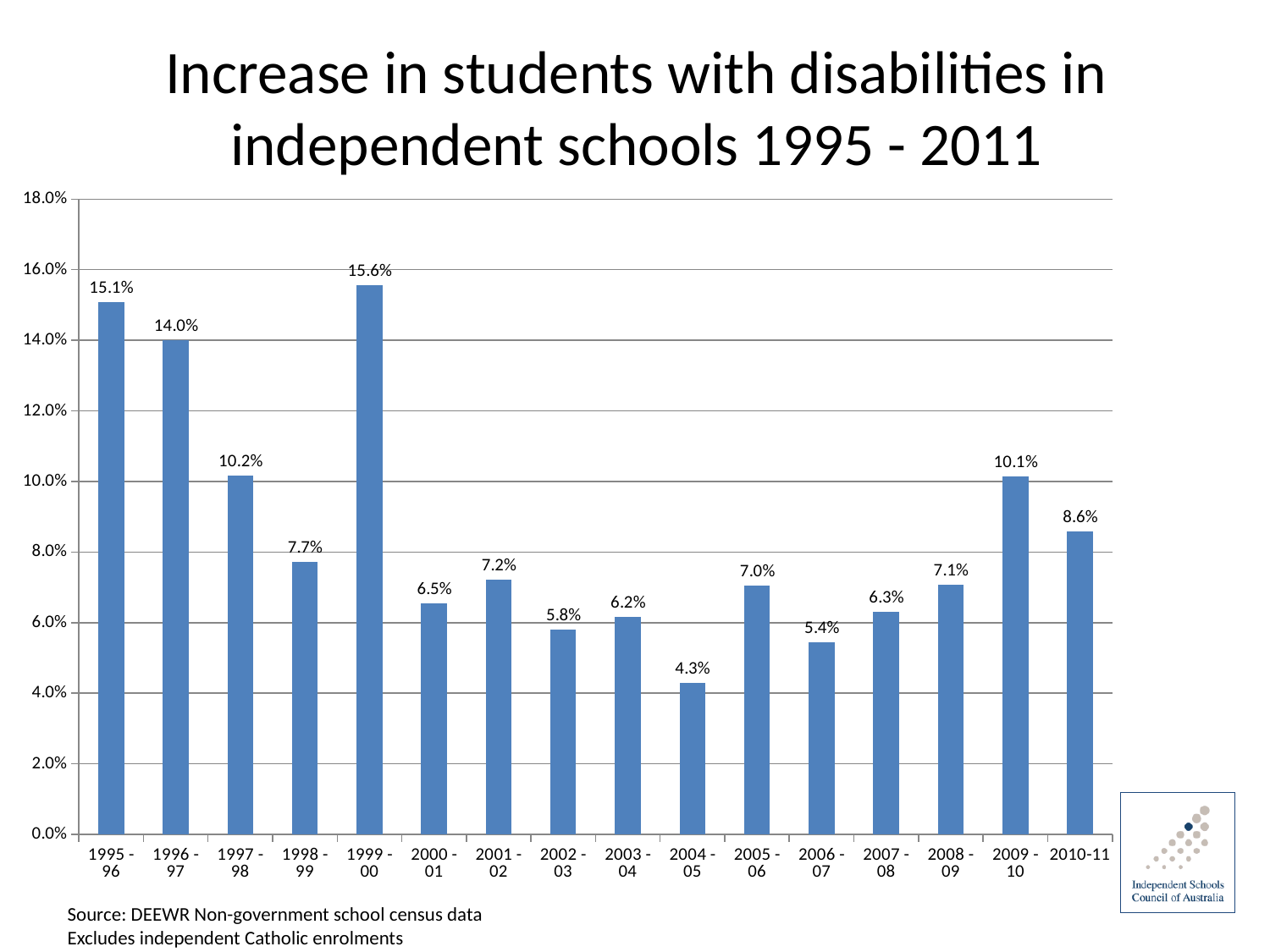
What is the value for 2010-11? 8.6% What is the difference between the values for 1995 - 96 and 1996 - 97? 1.1% Which period has the highest value? 1999 - 00 Which is larger, the value for 1997 - 98 or the value for 2009 - 10? 1997 - 98 Which period has the lowest value? 2004 - 05 How many periods are shown on the x axis? 16 What is the value for 1999 - 00? 15.6% What is the value for 2004 - 05? 4.3% What is the difference between the values for 2009 - 10 and 2010-11? 1.5% Is the value for 2006 - 07 greater or less than 6.0%? less What kind of chart is shown on the slide? bar chart What is the title of the chart? Increase in students with disabilities in independent schools 1995 - 2011